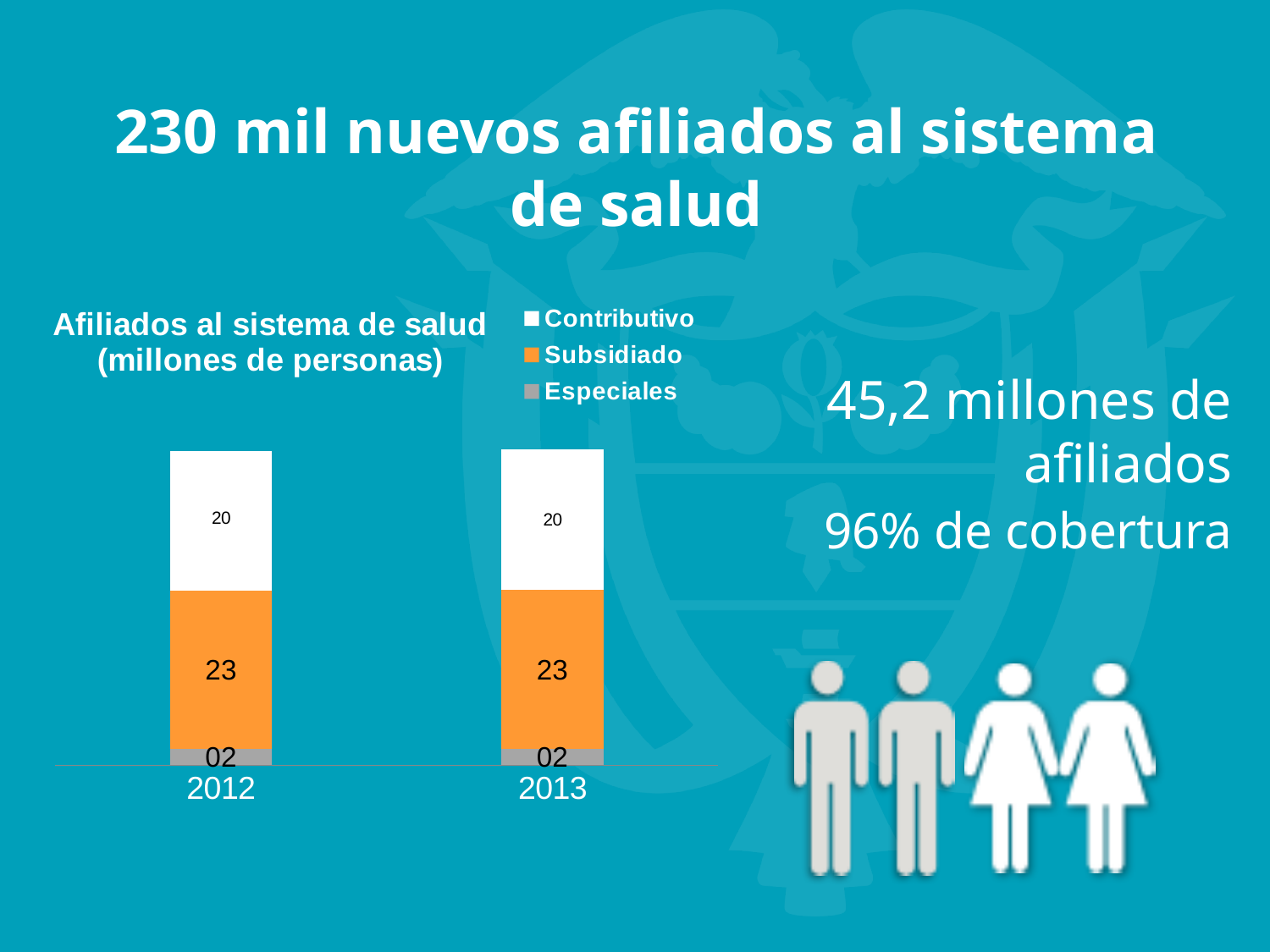
Which colour represents the Subsidiado series in the chart? orange What is the value for Especiales in 2013? 02 What is the title of the chart on the slide? Afiliados al sistema de salud (millones de personas) What is the difference between the Subsidiado and Contributivo values in 2013? 3 Which series has the largest value in 2013? Subsidiado What is the value for Contributivo in 2013? 20 Which is larger in 2012, Subsidiado or Contributivo? Subsidiado What is the value for Subsidiado in 2012? 23 What kind of chart is shown on the slide? stacked bar chart Which series has the smallest value in 2012? Especiales How many years (categories) are shown on the x axis of the chart? 2 How many series does the chart legend list? 3